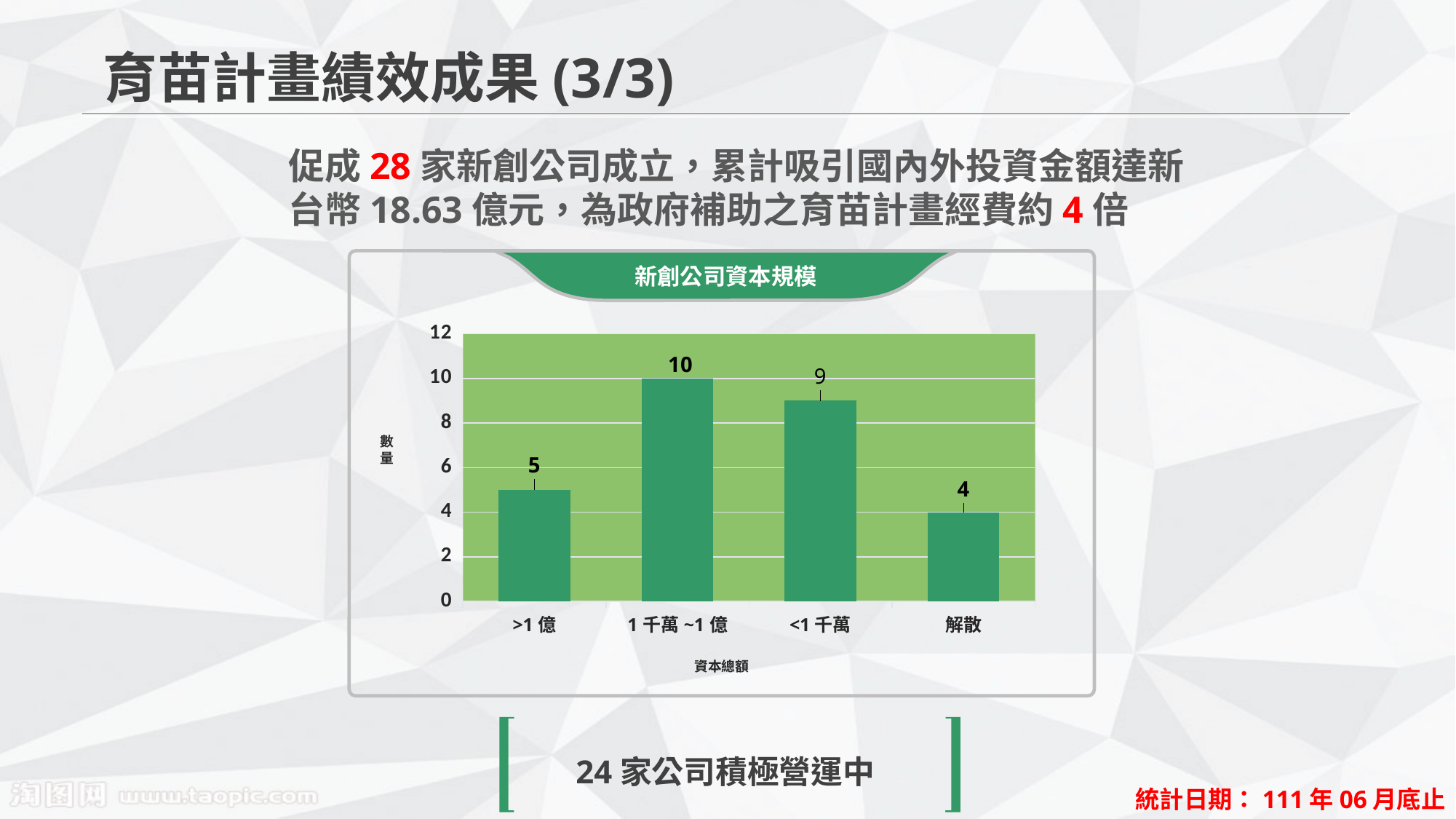
What is the difference between the values for 1 千萬 ~1 億 and 解散? 6 Which is larger, the value for >1 億 or the value for <1 千萬? <1 千萬 What is the value for the <1 千萬 category? 9 What is the value for the >1 億 category? 5 What is the title of the chart? 新創公司資本規模 What is the value for the 1 千萬 ~1 億 category? 10 Which category has the highest value? 1 千萬 ~1 億 Which category has the lowest value? 解散 What kind of chart is shown on the slide? bar chart How many categories are shown on the x axis? 4 What is the label of the x axis? 資本總額 What is the value for the 解散 category? 4